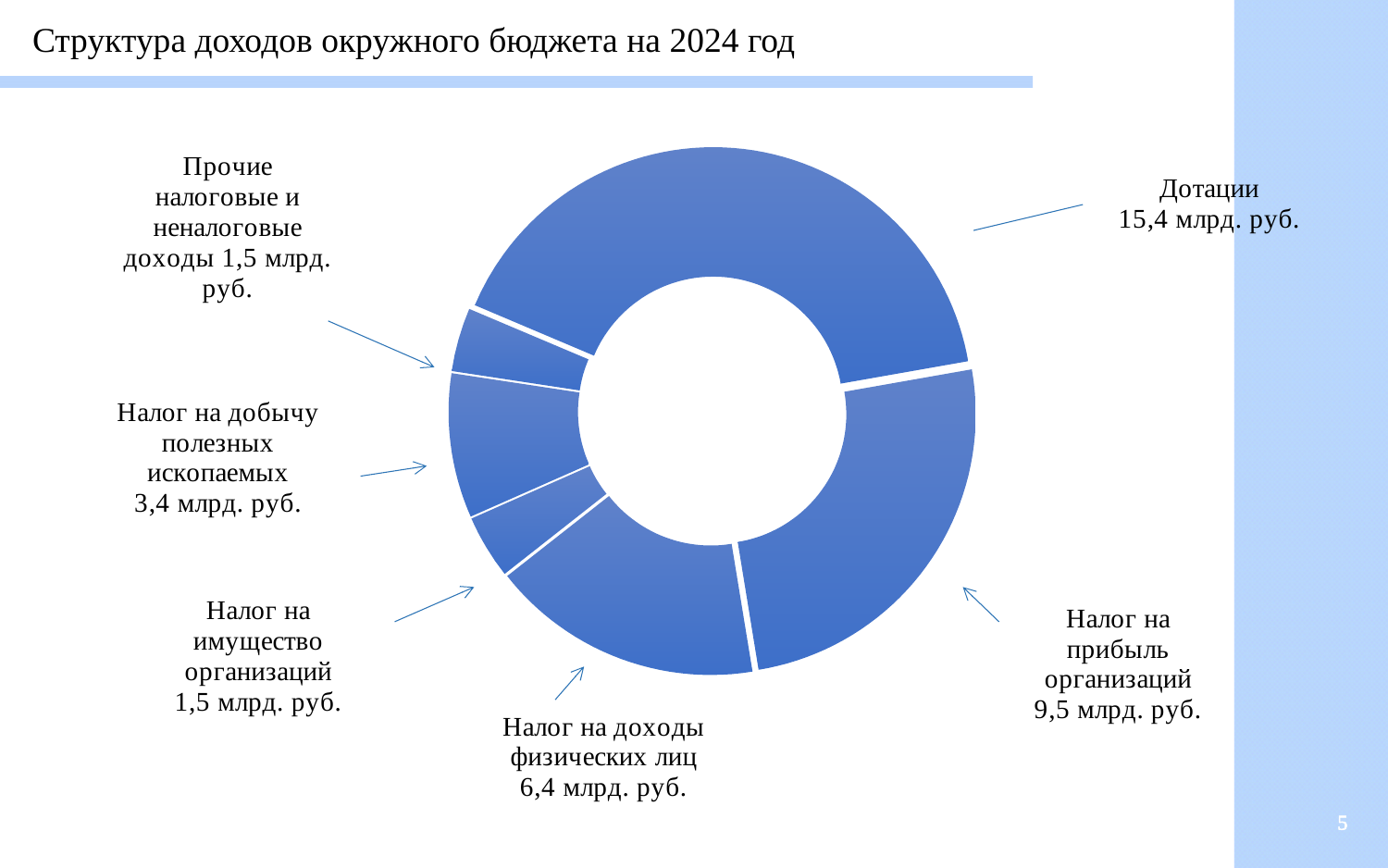
What is the value for Налог на имущество организаций? 1,5 млрд. руб. What is the total of all segments in the chart? 37,7 млрд. руб. How many segments does the pie chart have? 6 What is the value for Налог на доходы физических лиц? 6,4 млрд. руб. What is the difference between Дотации and Налог на прибыль организаций? 5,9 млрд. руб. Which is larger: Налог на доходы физических лиц or Налог на добычу полезных ископаемых? Налог на доходы физических лиц What is the value for Налог на прибыль организаций? 9,5 млрд. руб. What is the title of the chart on the slide? Структура доходов окружного бюджета на 2024 год Which category has the largest value in the chart? Дотации What is the value for Налог на добычу полезных ископаемых? 3,4 млрд. руб. What kind of chart is shown on the slide? Pie (donut) chart What is the value for Дотации? 15,4 млрд. руб.